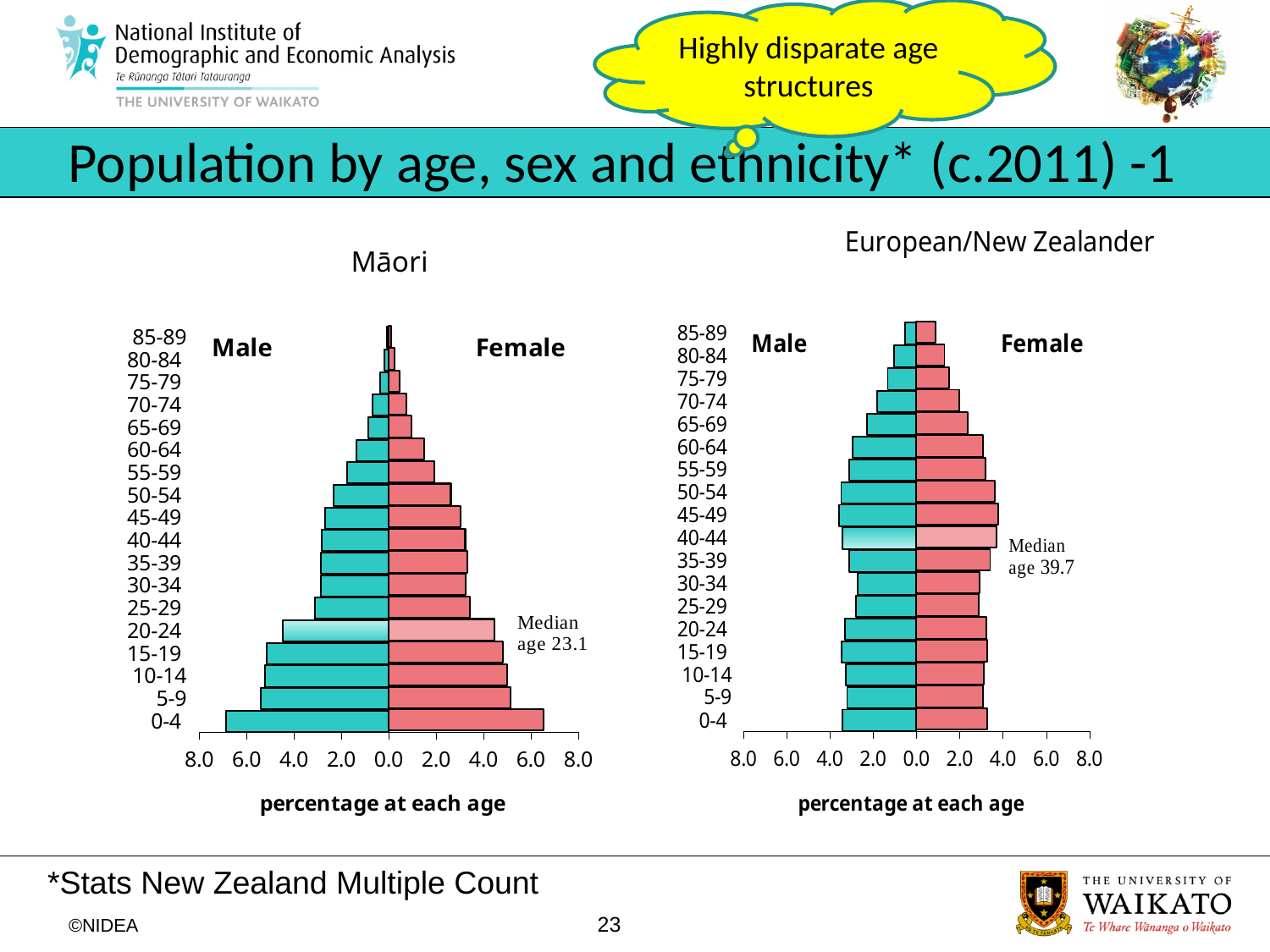
Which group has the higher annotated median age, Māori or European/New Zealander? European/New Zealander On the Māori chart, is the male value for the 0-4 age group greater or less than 6.0? greater On the Māori chart, which age group has the shortest male bar? 85-89 On the European/New Zealander chart, is the male value for the 0-4 age group greater or less than 4.0? less On the European/New Zealander chart, is the female value for the 45-49 age group greater or less than 2.0? greater What median age is annotated on the Māori chart? 23.1 What median age is annotated on the European/New Zealander chart? 39.7 On the Māori chart, do the bars generally get longer or shorter as age increases from 0-4 to 85-89? shorter On the Māori chart, which age group has the longest female bar? 0-4 What is the x-axis label on the European/New Zealander chart? percentage at each age What kind of chart is the Māori chart on the left? bar chart How many age groups are shown on the Māori chart? 18